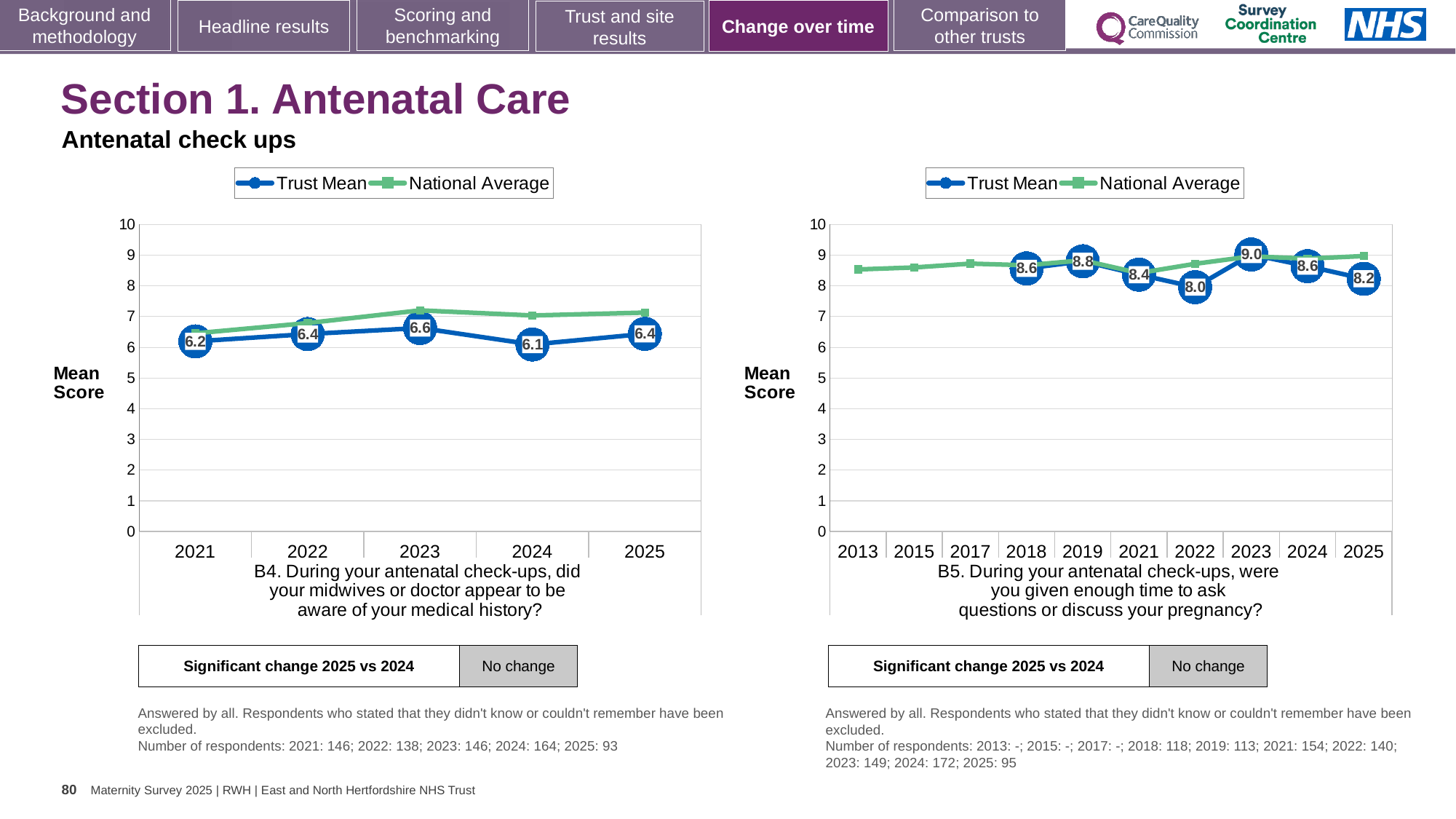
In the right chart (B5), is the National Average for 2013 greater or less than 8? greater In the left chart (B4), what is the Trust Mean for 2024? 6.1 In the left chart (B4), what is the Trust Mean for 2023? 6.6 In the right chart (B5), what is the Trust Mean for 2022? 8.0 In the right chart (B5), how many series does the legend list? 2 In the right chart (B5), which year has the lowest labelled Trust Mean? 2022 In the left chart (B4), how many years are shown on the x axis? 5 In the left chart (B4), which year has the lowest Trust Mean? 2024 In the left chart (B4), what is the difference between the Trust Mean in 2023 and in 2024? 0.5 What type of chart is the left chart (B4)? Line chart In the right chart (B5), is the Trust Mean higher in 2019 or in 2025? 2019 In the right chart (B5), which year has the highest Trust Mean? 2023